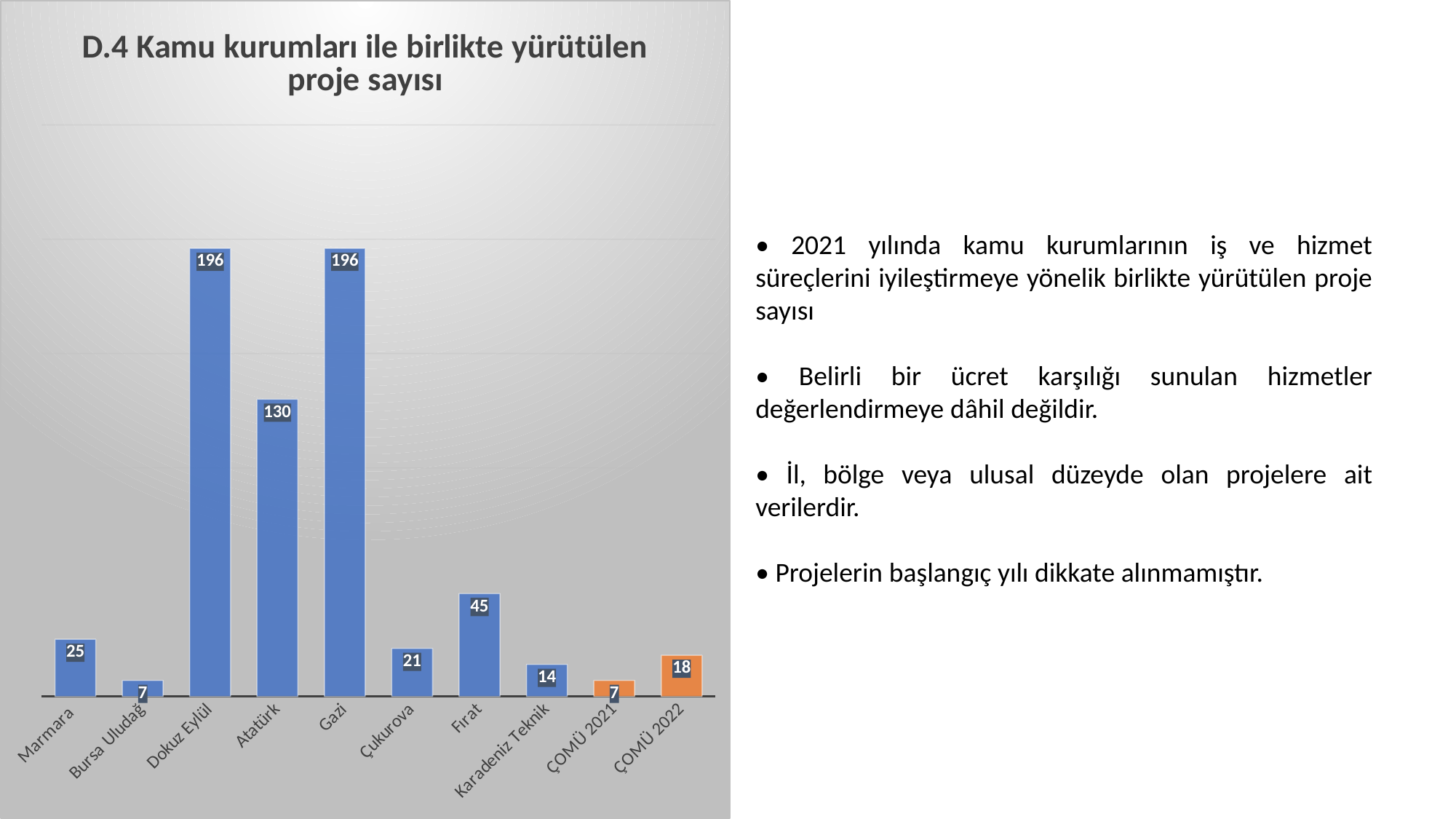
What is the lowest value shown in the chart? 7 What is the value for ÇOMÜ 2022? 18 What is the value for Atatürk? 130 How many categories are shown on the x axis? 10 What is the value for Karadeniz Teknik? 14 Which has a larger value, Marmara or Çukurova? Marmara What is the difference between the values for Dokuz Eylül and Atatürk? 66 What kind of chart is this? Bar chart What is the value for Fırat? 45 What is the title of the chart? D.4 Kamu kurumları ile birlikte yürütülen proje sayısı What is the highest value shown in the chart? 196 What is the difference between the values for ÇOMÜ 2022 and ÇOMÜ 2021? 11